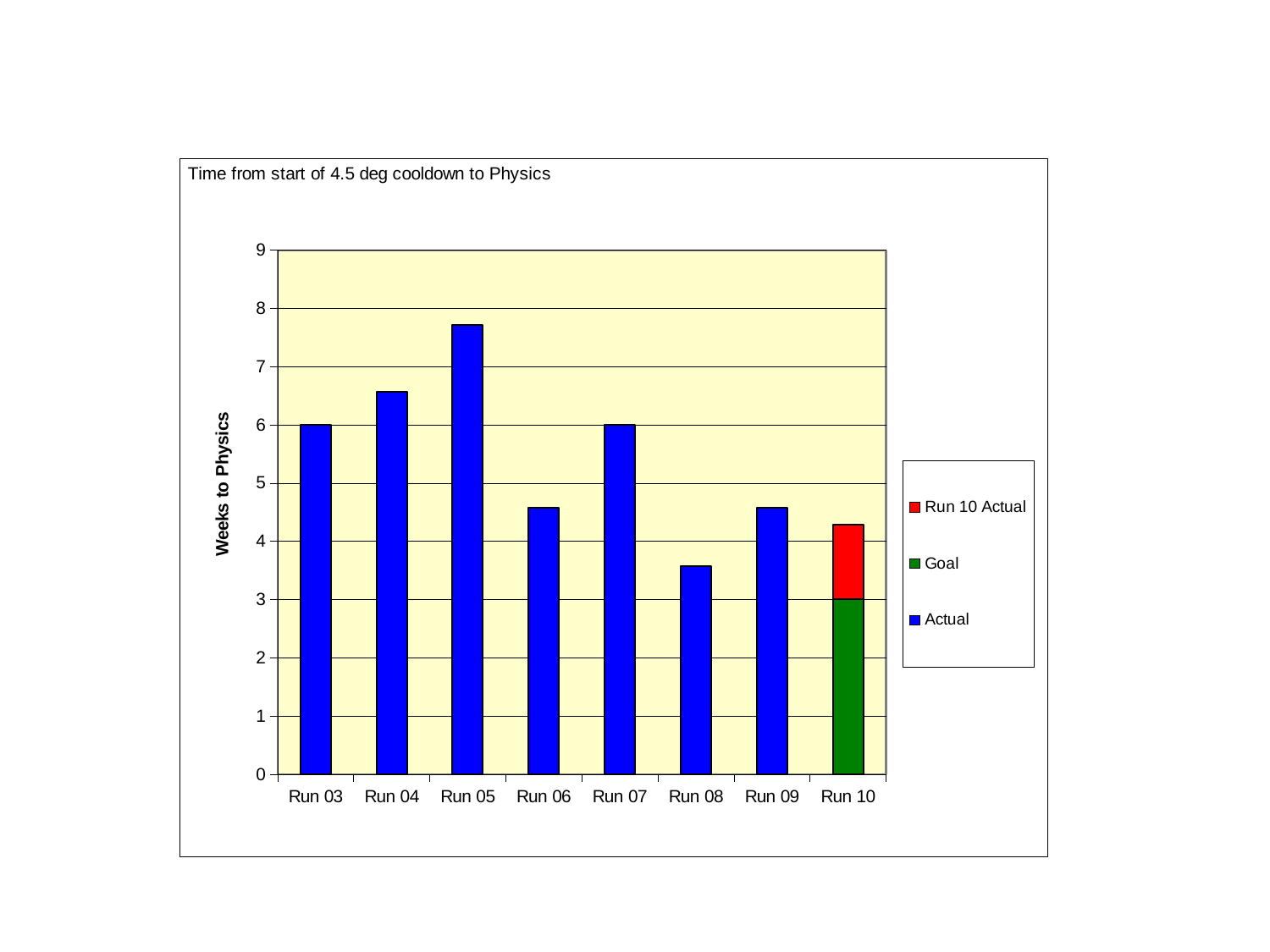
How many runs are shown along the x axis? 8 What is the Goal value in weeks for Run 10? 3 How many series does the legend list? 3 Which run has the highest Weeks to Physics value? Run 05 Which has the larger Weeks to Physics value, Run 04 or Run 06? Run 04 What is the label of the vertical axis? Weeks to Physics What is the Actual value in weeks for Run 07? 6 What is the Actual value in weeks for Run 03? 6 What type of chart is shown on the slide? Bar chart Is the value for Run 05 greater or less than 7? greater Which run has the lowest Weeks to Physics value? Run 08 What is the title of the chart? Time from start of 4.5 deg cooldown to Physics